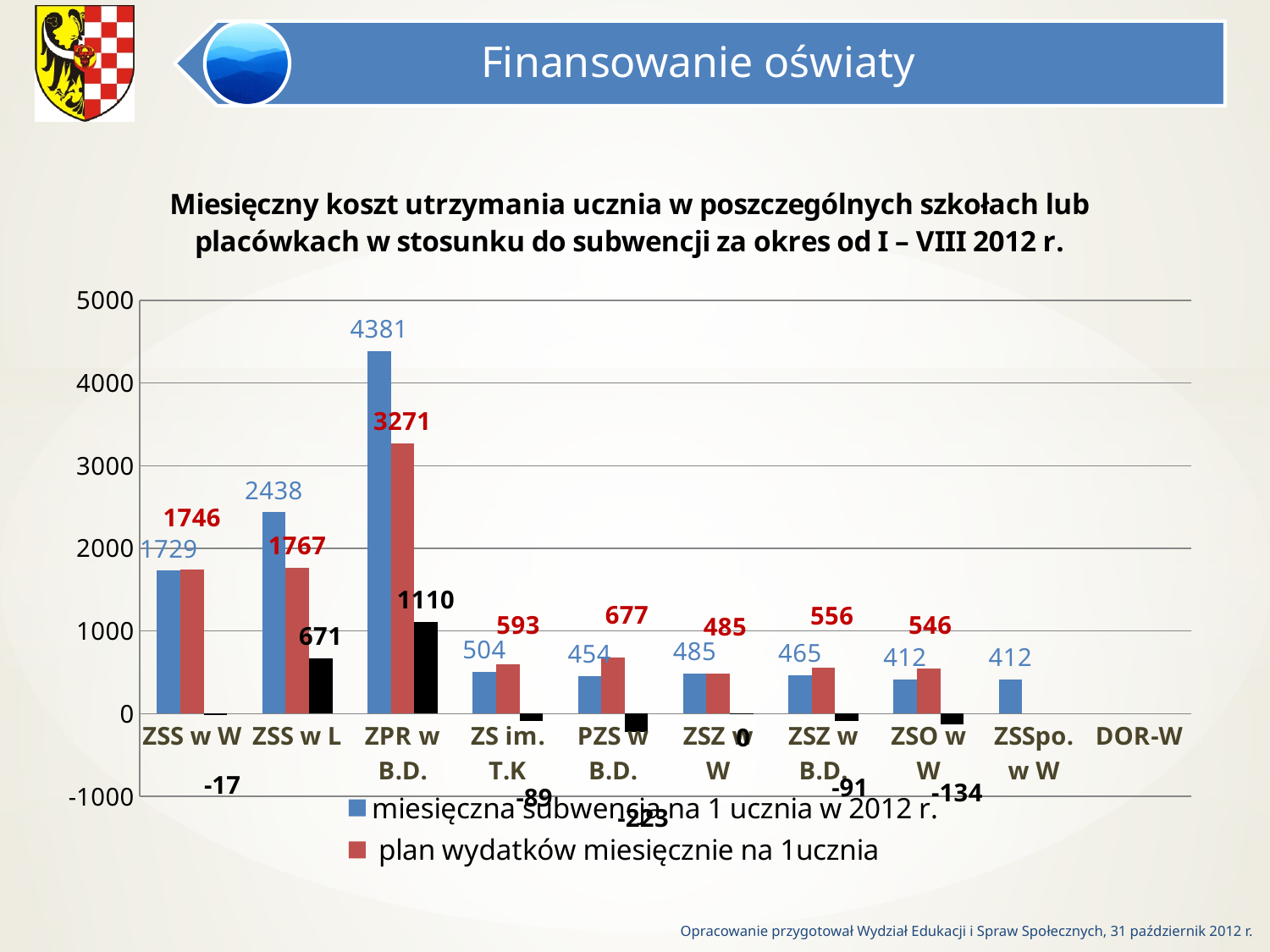
What is the difference between 'miesięczna subwencja na 1 ucznia w 2012 r.' and 'plan wydatków miesięcznie na 1ucznia' for ZPR w B.D.? 1110 Which school has the lowest labelled 'plan wydatków miesięcznie na 1ucznia' value? ZSZ w W What is the value of 'miesięczna subwencja na 1 ucznia w 2012 r.' for ZPR w B.D.? 4381 What colour represents 'miesięczna subwencja na 1 ucznia w 2012 r.' in the chart? blue Which school has the highest 'miesięczna subwencja na 1 ucznia w 2012 r.'? ZPR w B.D. For ZSS w W, which is larger: 'miesięczna subwencja na 1 ucznia w 2012 r.' or 'plan wydatków miesięcznie na 1ucznia'? plan wydatków miesięcznie na 1ucznia Is the 'plan wydatków miesięcznie na 1ucznia' value for ZPR w B.D. greater or less than 3000? greater What kind of chart is shown on the slide? bar chart What is the value of the black bar for PZS w B.D.? -223 What is the value of 'plan wydatków miesięcznie na 1ucznia' for ZSS w L? 1767 How many series does the legend list? 2 How many schools or institutions are listed on the x axis? 10